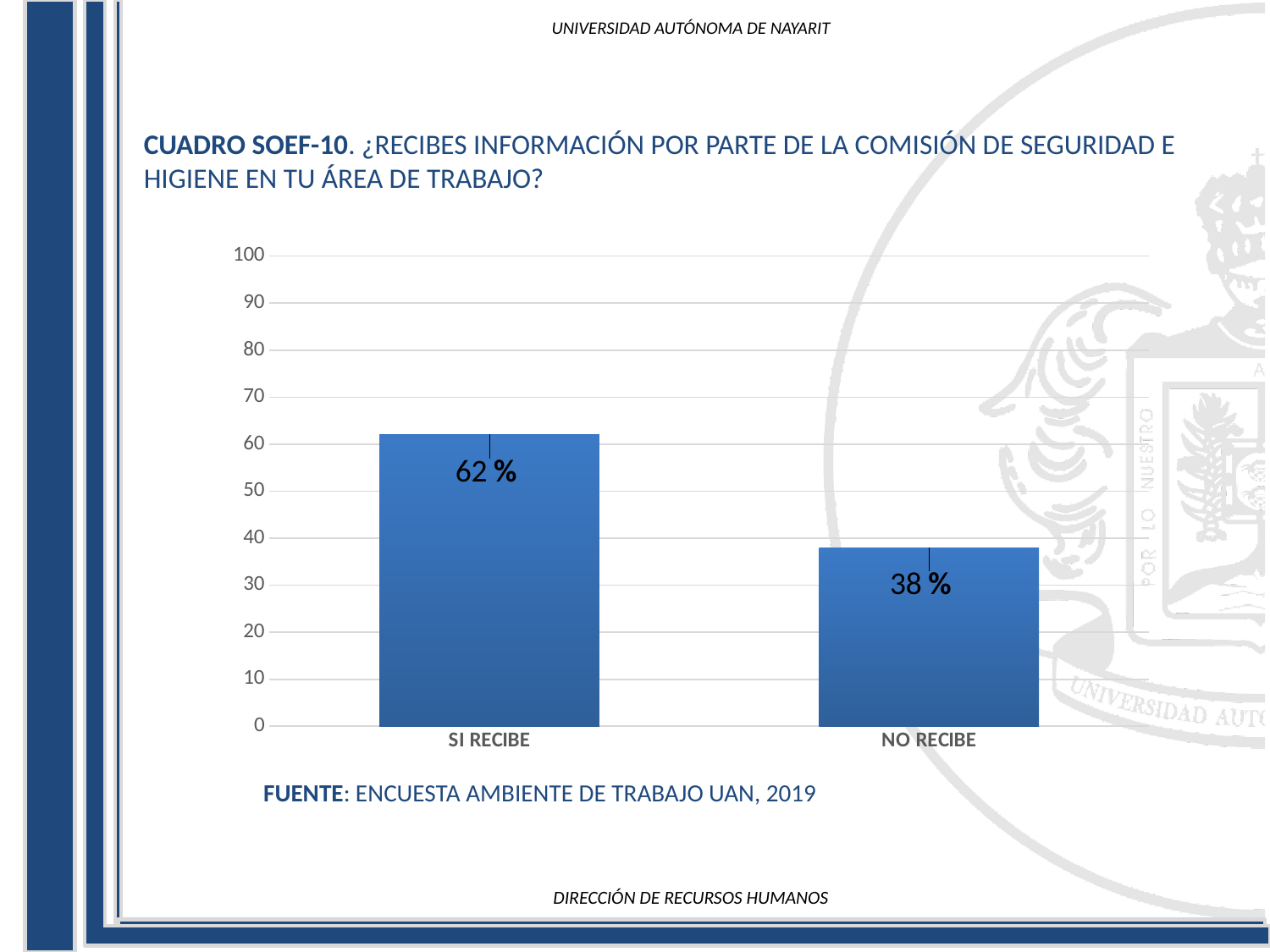
What is the value for NO RECIBE? 38 % What is the difference between the values for SI RECIBE and NO RECIBE? 24 % What is the total of the two values shown in the chart? 100 % What kind of chart is shown on the slide? bar chart Which is larger, the value for SI RECIBE or NO RECIBE? SI RECIBE How many categories are shown in the chart? 2 Which category has the highest value? SI RECIBE What is the value for SI RECIBE? 62 % Is the value for NO RECIBE greater or less than 40? less Is the value for SI RECIBE greater or less than 50? greater What is the source cited below the chart? ENCUESTA AMBIENTE DE TRABAJO UAN, 2019 Which category has the lowest value? NO RECIBE